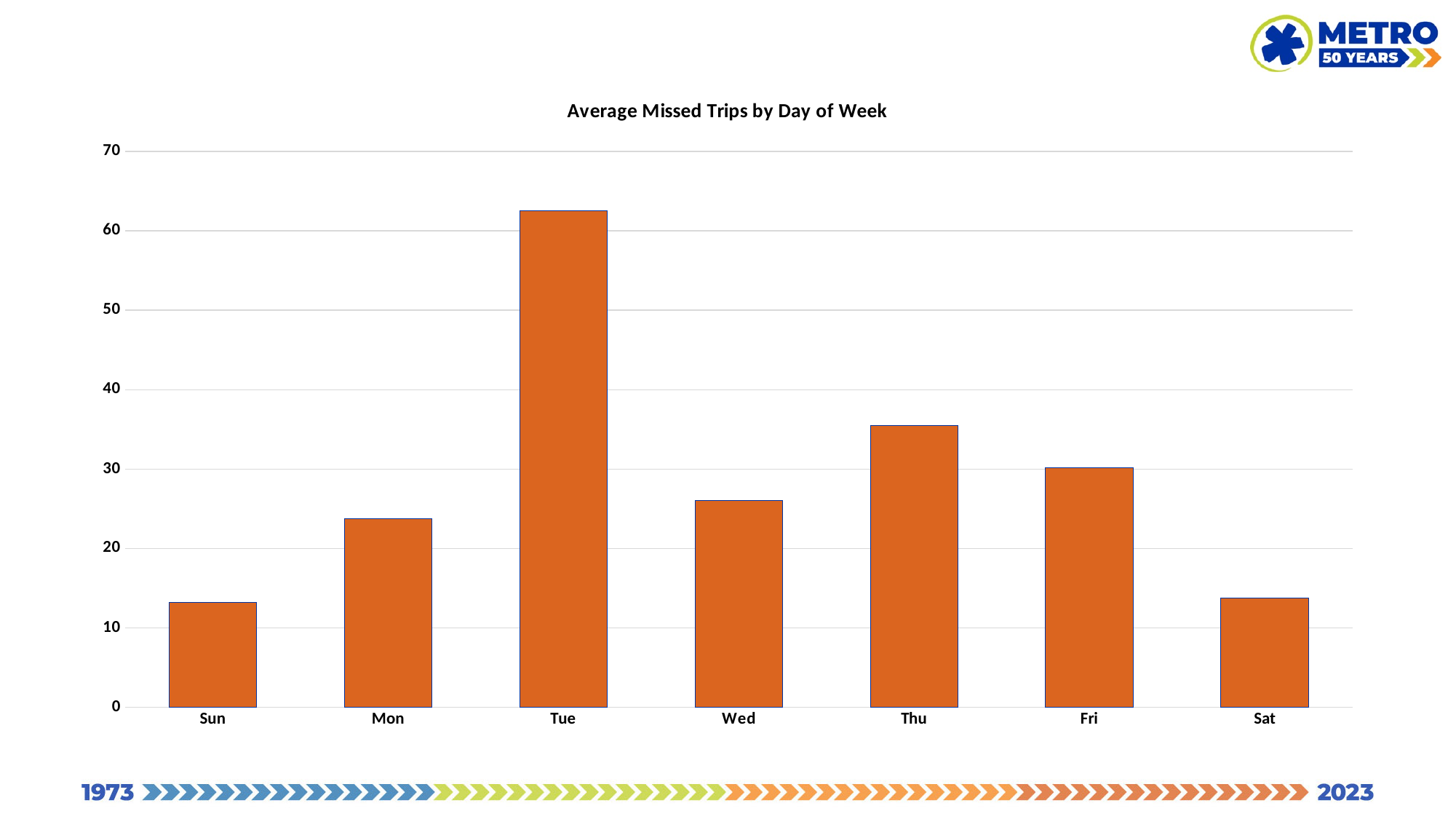
Is the value for Thu greater or less than 30? greater What is the title of the chart? Average Missed Trips by Day of Week What kind of chart is shown on the slide? bar chart How many days of the week are shown on the x axis? 7 Is the value for Wed greater or less than 30? less Is the value for Mon greater or less than 20? greater Which day has the highest average missed trips? Tue Which is larger, the value for Tue or the value for Wed? Tue Which is larger, the value for Thu or the value for Fri? Thu